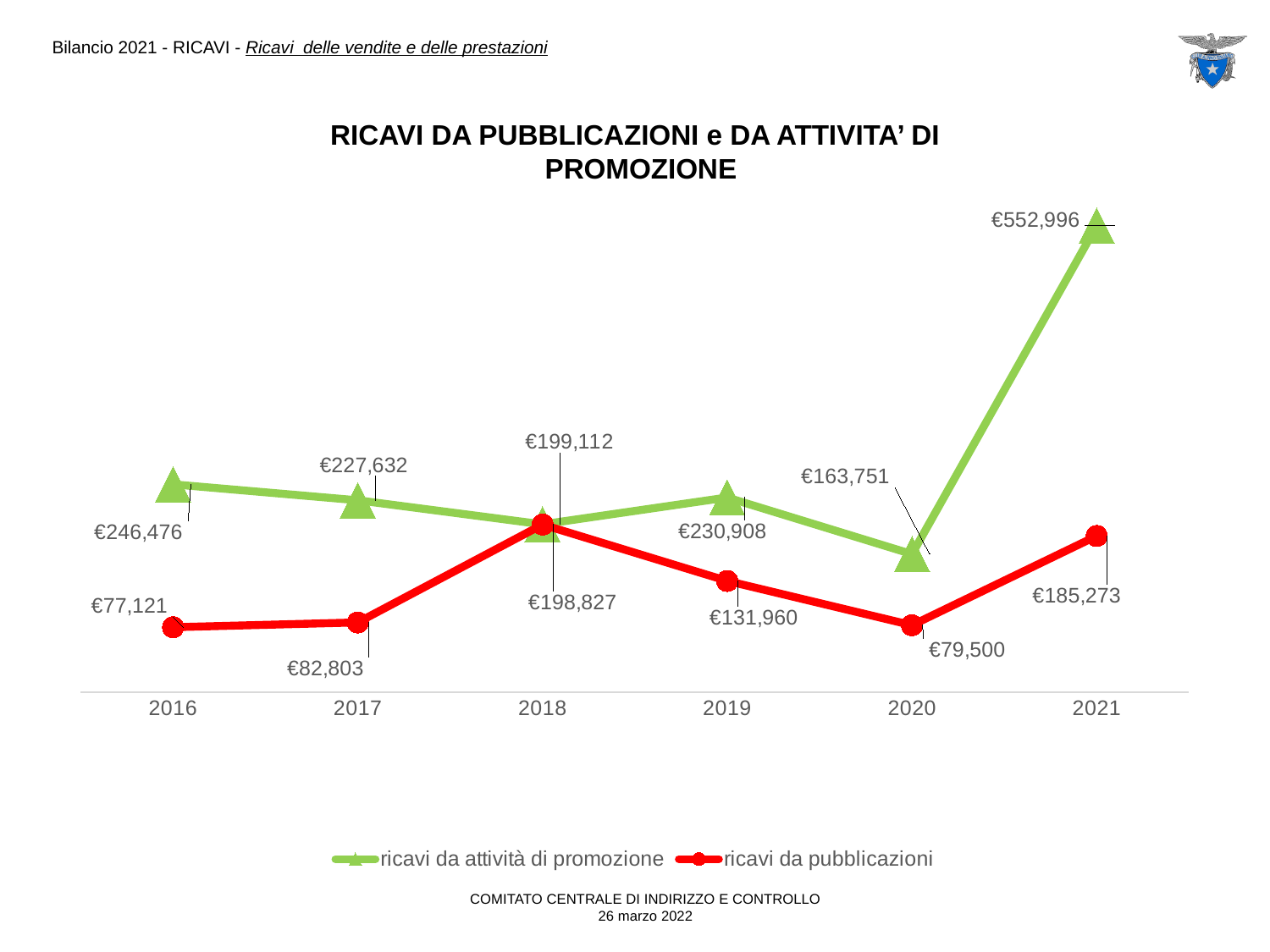
In which year is ricavi da attività di promozione highest? 2021 What is the value of ricavi da pubblicazioni in 2016? €77,121 What is the value of ricavi da attività di promozione in 2019? €230,908 In 2019, which series has the larger value: ricavi da attività di promozione or ricavi da pubblicazioni? ricavi da attività di promozione What is the value of ricavi da attività di promozione in 2021? €552,996 In which year is ricavi da pubblicazioni highest? 2018 How many years are shown on the x axis? 6 In which year is ricavi da attività di promozione lowest? 2020 By how much did ricavi da attività di promozione increase from 2020 to 2021? €389,245 How many series does the legend list? 2 What is the difference between ricavi da pubblicazioni in 2021 and in 2020? €105,773 What kind of chart is this? line chart